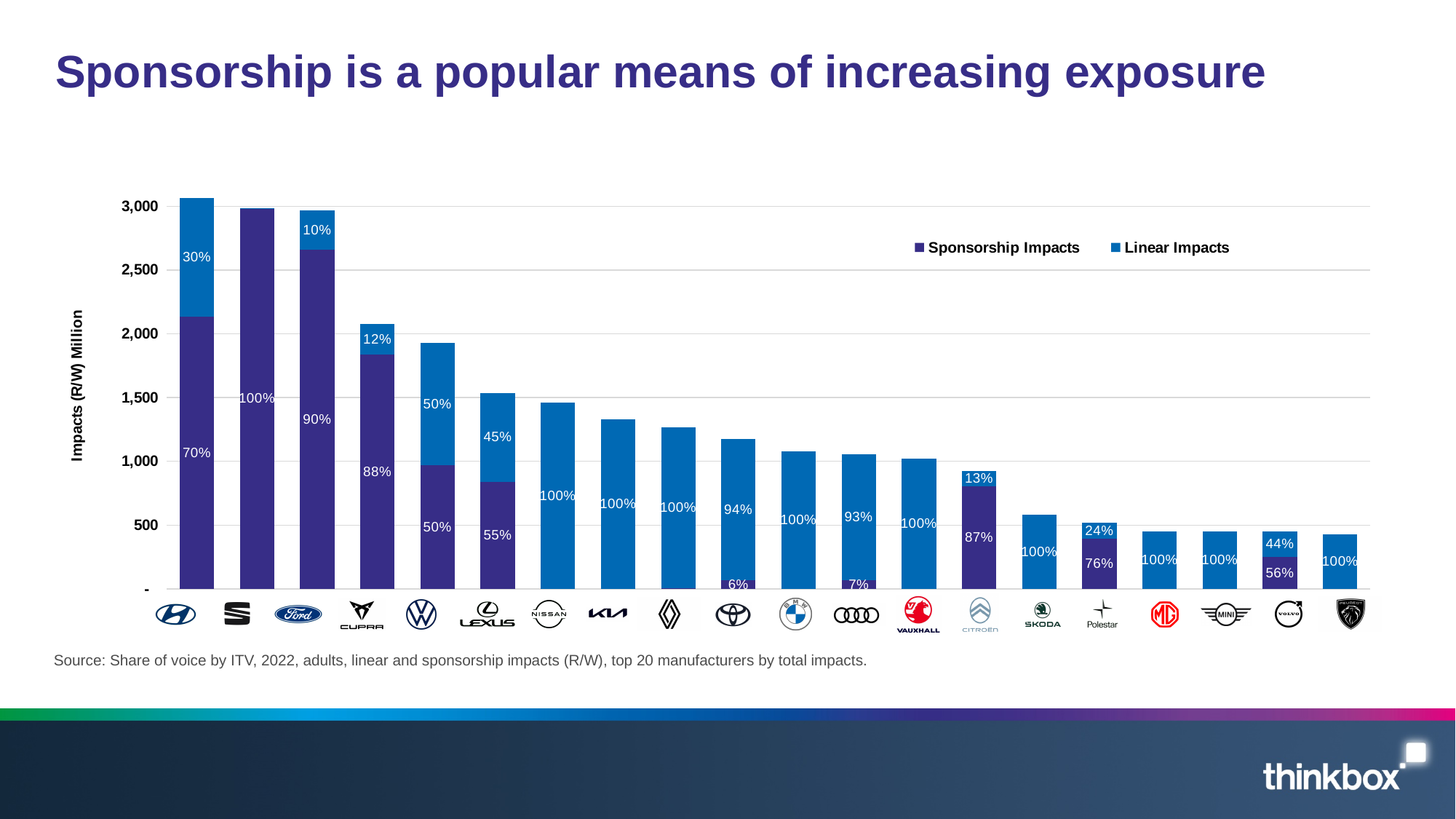
What percentage of Lexus's impacts are Linear Impacts? 45% What percentage of Polestar's impacts are Linear Impacts? 24% Is the total impacts value for Skoda greater or less than 1,000? less What percentage of Citroën's impacts are Sponsorship Impacts? 87% What percentage of Cupra's impacts are Sponsorship Impacts? 88% Is the total impacts value for Nissan greater or less than 1,000? greater How many series does the legend list? 2 How many manufacturers (bars) are plotted in the chart? 20 What kind of chart is shown on the slide? Stacked bar chart What percentage of Volvo's impacts are Sponsorship Impacts? 56% Which has the larger total impacts, Nissan or Skoda? Nissan What is the title of the vertical axis? Impacts (R/W) Million